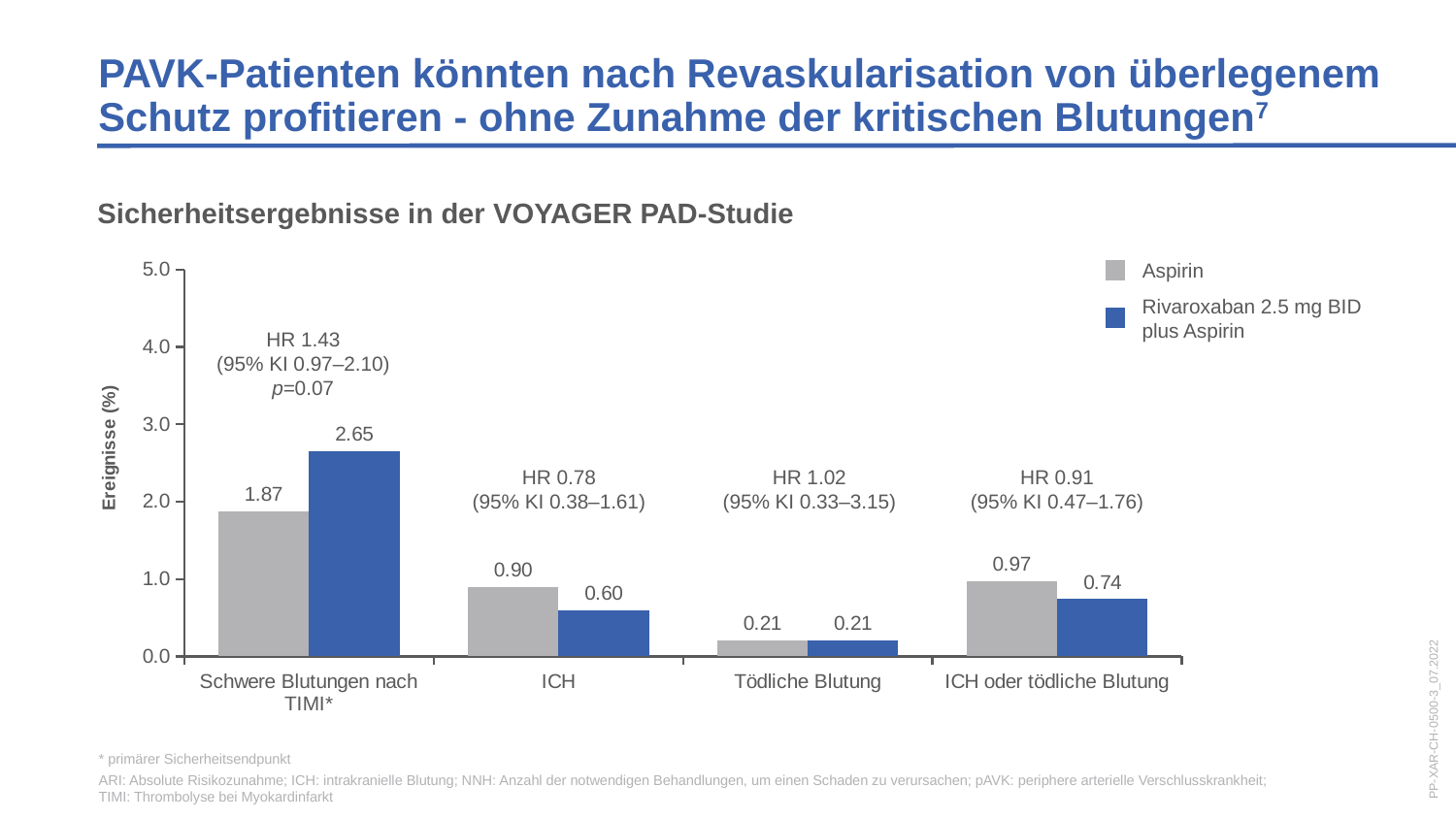
Which category has the highest value for Rivaroxaban 2.5 mg BID plus Aspirin? Schwere Blutungen nach TIMI* How many series does the legend list? 2 What kind of chart is shown on the slide? Bar chart Which category has the lowest value for Aspirin? Tödliche Blutung What is the difference between the Rivaroxaban 2.5 mg BID plus Aspirin value and the Aspirin value in the 'Schwere Blutungen nach TIMI*' category? 0.78 What is the value for Aspirin in the ICH category? 0.90 How many categories are shown on the x axis of the chart? 4 What is the value for Rivaroxaban 2.5 mg BID plus Aspirin in the 'ICH oder tödliche Blutung' category? 0.74 What is the hazard ratio (HR) shown above the 'Tödliche Blutung' category? HR 1.02 What is the value for Rivaroxaban 2.5 mg BID plus Aspirin in the 'Schwere Blutungen nach TIMI*' category? 2.65 In the ICH category, which series has the larger value, Aspirin or Rivaroxaban 2.5 mg BID plus Aspirin? Aspirin What is the value for Aspirin in the 'Schwere Blutungen nach TIMI*' category? 1.87